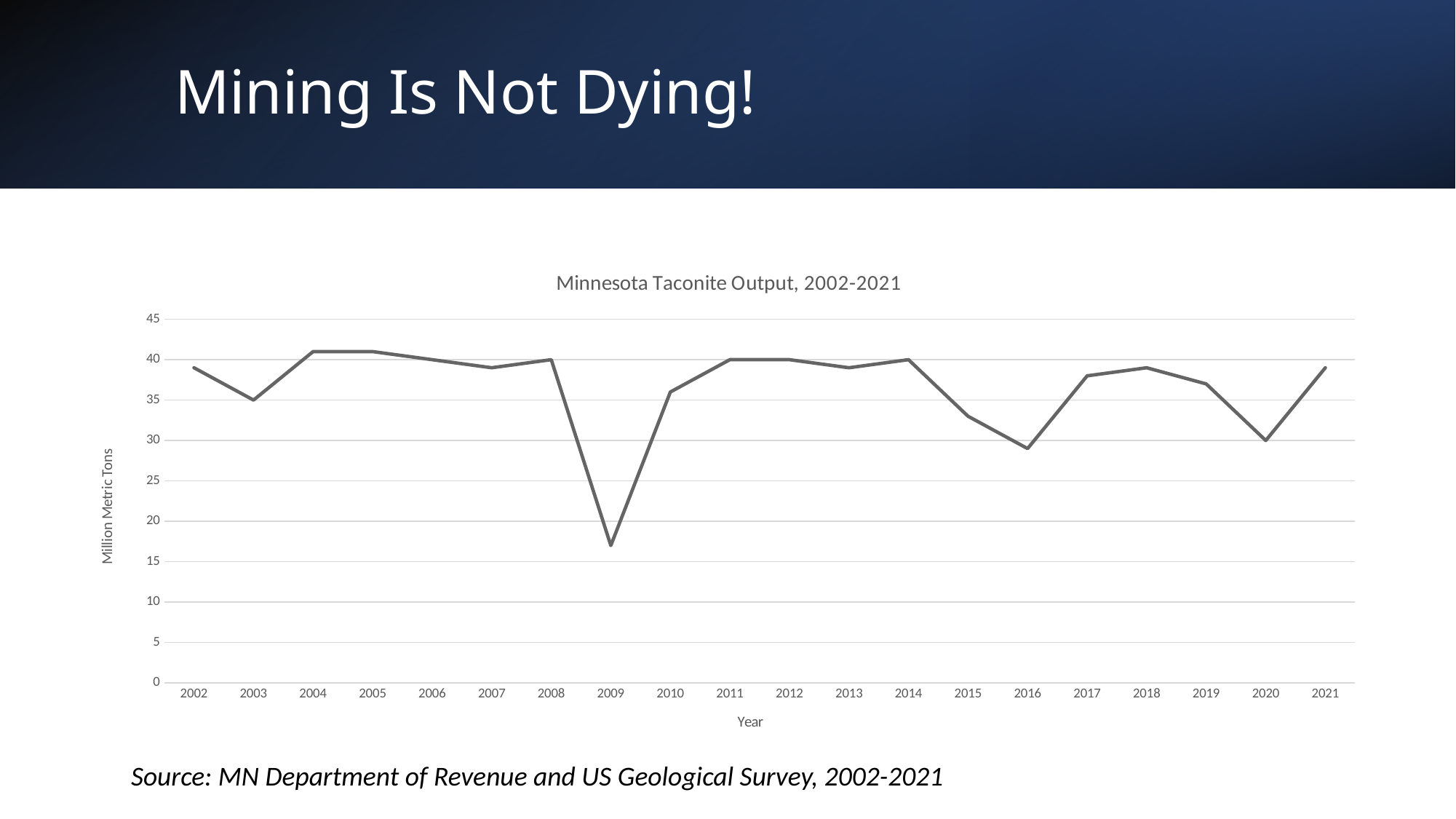
Is the value for 2009 greater or less than 20? less What is the taconite output for 2003, in million metric tons? 35 What kind of chart is shown on the slide? line chart What is the difference between the output in 2008 and the output in 2003, in million metric tons? 5 What is the title of the chart? Minnesota Taconite Output, 2002-2021 Is the value for 2004 greater or less than 40? greater How many years are plotted on the x axis? 20 Which year has the larger output, 2016 or 2017? 2017 Which year has the lowest taconite output? 2009 What is the label of the vertical axis? Million Metric Tons Does the output rise or fall from 2018 to 2020? fall What is the taconite output for 2020, in million metric tons? 30